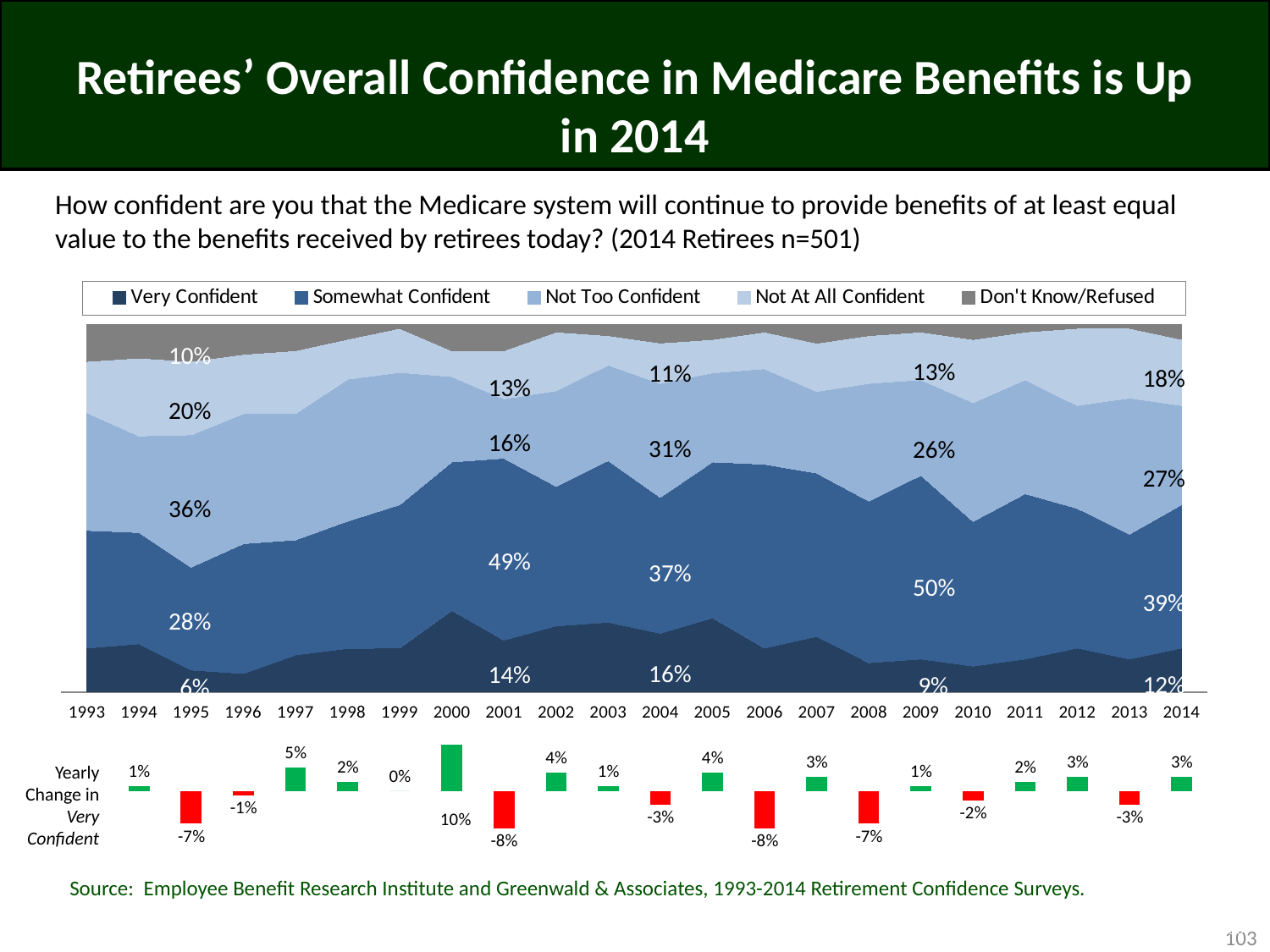
In the main stacked area chart, what percentage of retirees were Very Confident in 2014? 12% In the main stacked area chart, which is larger: the Very Confident share in 2001 or in 2009? 2001 In the main stacked area chart, what percentage of retirees were Not Too Confident in 2004? 31% In the 'Yearly Change in Very Confident' bar chart at the bottom, what is the value for 2000? 10% How many series does the legend of the main stacked area chart list? 5 In the main stacked area chart, what is the difference between the Somewhat Confident share in 2001 and in 2014? 10% In the 'Yearly Change in Very Confident' bar chart at the bottom, what is the value for 2008? -7% In the 'Yearly Change in Very Confident' bar chart at the bottom, which year shows a value of 0%? 1999 In the 'Yearly Change in Very Confident' bar chart at the bottom, which year has the highest value? 2000 What kind of chart is the 'Yearly Change in Very Confident' chart at the bottom of the slide? Bar chart In the main stacked area chart, what percentage of retirees were Not At All Confident in 1995? 20% In the main stacked area chart, what percentage of retirees were Somewhat Confident in 2009? 50%